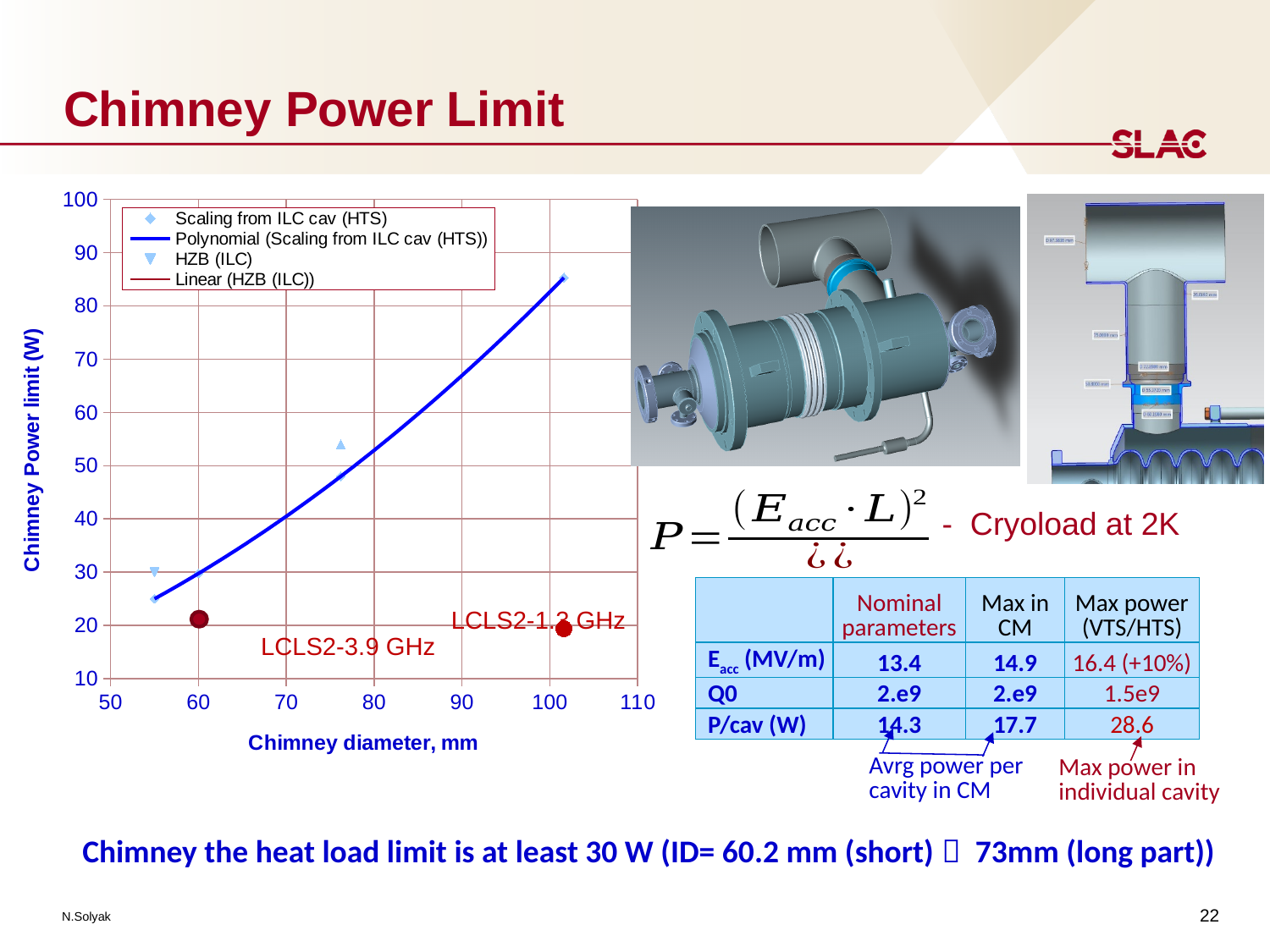
What type of chart is shown on the left of the slide? scatter chart What is the title of the y axis of the chart? Chimney Power limit (W) Is the value of the 'Scaling from ILC cav (HTS)' point at the largest chimney diameter (about 100 mm) greater or less than 80 W? greater What is the title of the x axis of the chart? Chimney diameter, mm What is the maximum value shown on the x axis of the chart? 110 Is the value of the LCLS2-3.9 GHz point greater or less than 30 W? less How many series does the legend of the chart list? 4 Is the value of the 'Scaling from ILC cav (HTS)' point at the smallest chimney diameter (about 55 mm) greater or less than 30 W? less Which of the two labelled LCLS2 points has the larger chimney diameter, LCLS2-3.9 GHz or LCLS2-1.3 GHz? LCLS2-1.3 GHz Does the chimney power limit rise or fall as the chimney diameter increases along the x axis? rise